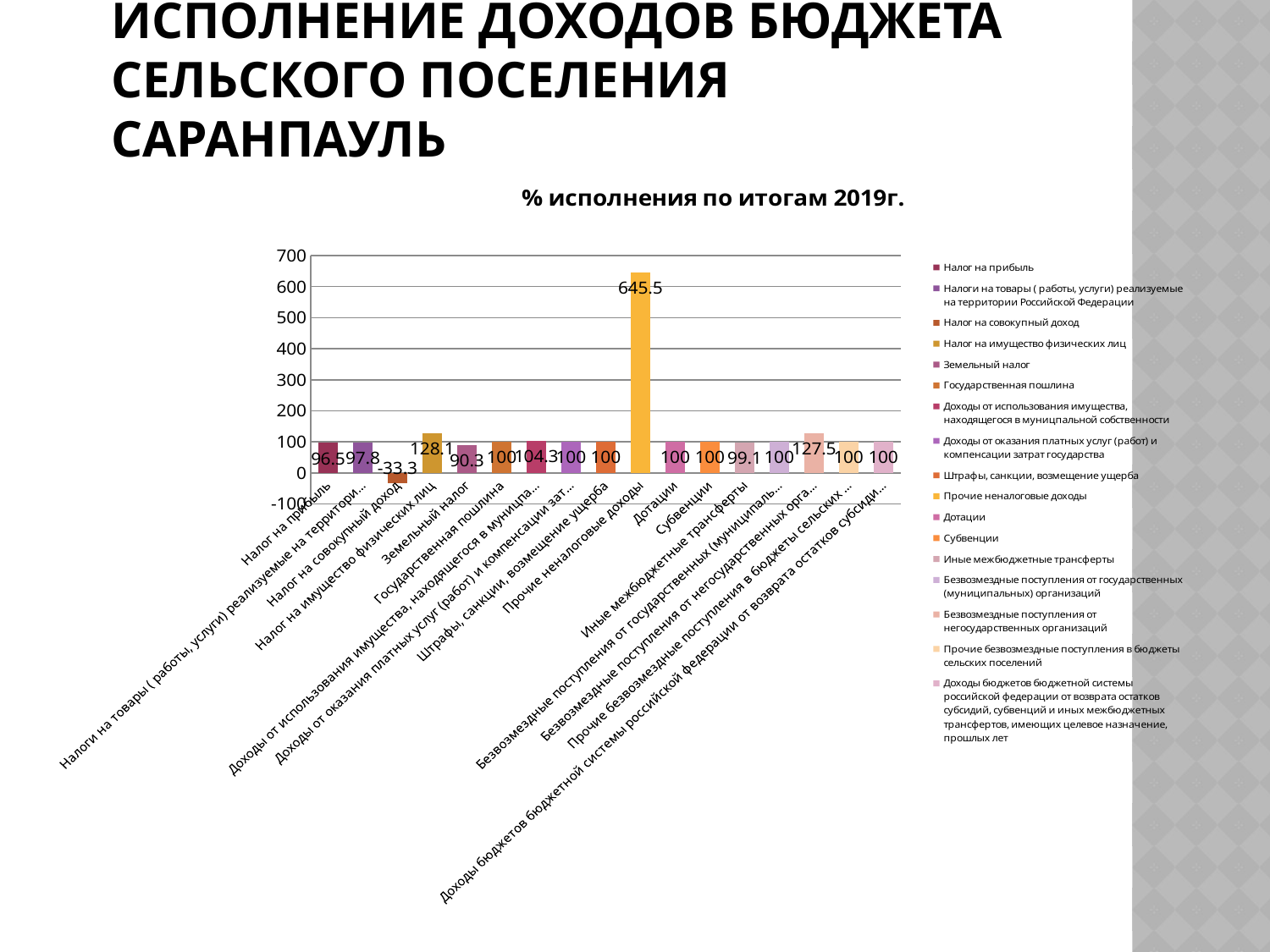
Which is larger: the value for Налог на прибыль or the value for Земельный налог? Налог на прибыль What is the value for Налог на имущество физических лиц? 128.1 What is the value for Прочие неналоговые доходы? 645.5 What is the value for Налог на совокупный доход? -33.3 What kind of chart is shown on the slide? bar chart How many bars are plotted in the chart? 17 Which category has the lowest value? Налог на совокупный доход Is the value for Прочие неналоговые доходы greater or less than 600? greater What is the title of the chart? % исполнения по итогам 2019г. What is the difference between the values for Прочие неналоговые доходы and Налог на имущество физических лиц? 517.4 What is the value for Земельный налог? 90.3 Which category has the highest value? Прочие неналоговые доходы